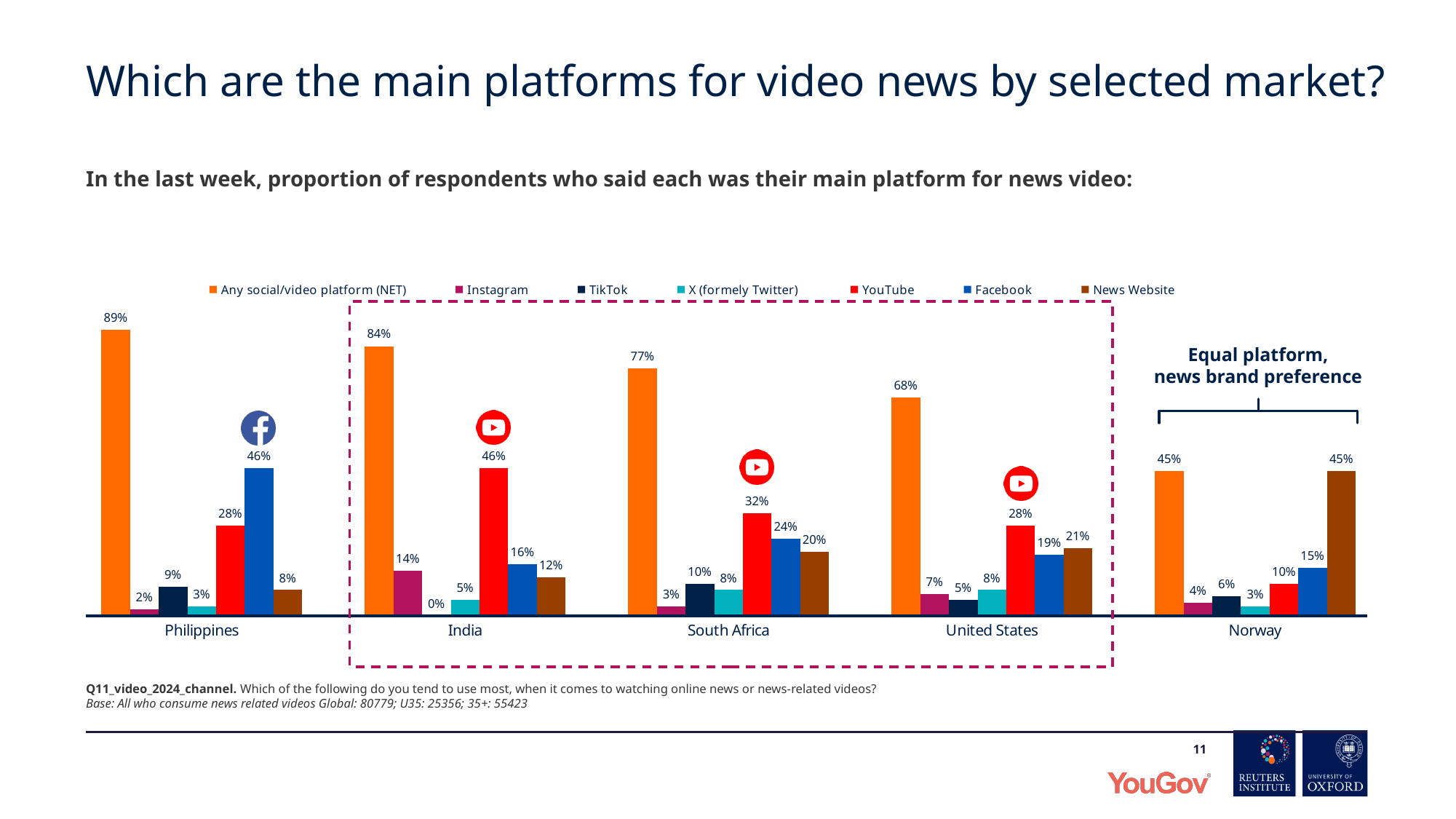
Which market has the lowest value for Any social/video platform (NET)? Norway What kind of chart is shown on the slide? Bar chart What is the value for News Website in Norway? 45% What percentage of respondents in the Philippines said Facebook was their main platform for news video? 46% In South Africa, which is larger: the value for YouTube or the value for Facebook? YouTube How many markets are shown on the x axis of the chart? 5 Which market has the highest value for Any social/video platform (NET)? Philippines What is the difference between the YouTube value and the Facebook value in the United States? 9% What is the value for X (formely Twitter) in India? 5% What is the value for YouTube in India? 46% What is the difference between the Any social/video platform (NET) value for India and for South Africa? 7% How many series does the legend list? 7